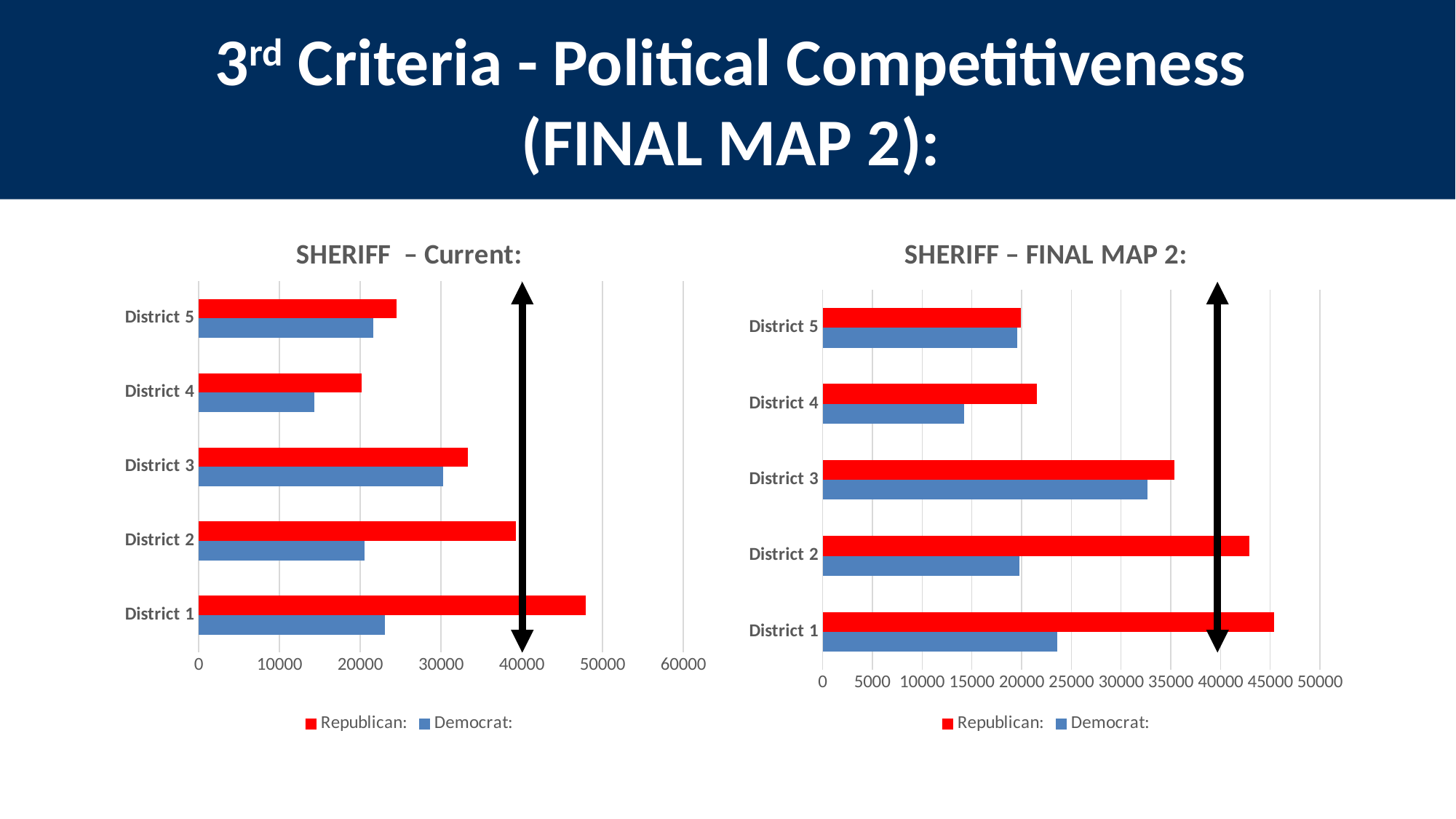
In the "SHERIFF – Current:" chart, which is larger for District 2, the Republican value or the Democrat value? Republican In the "SHERIFF – Current:" chart, is the Democrat value for District 4 greater or less than 20000? less What kind of chart is the "SHERIFF – Current:" chart? bar chart In the "SHERIFF – FINAL MAP 2:" chart, is the Republican value for District 3 greater or less than 30000? greater In the "SHERIFF – FINAL MAP 2:" chart, which district has the highest Republican value? District 1 In the "SHERIFF – Current:" chart, which district has the lowest Democrat value? District 4 In the "SHERIFF – Current:" chart, which district has the highest Republican value? District 1 How many series does the legend of the "SHERIFF – FINAL MAP 2:" chart list? 2 What colour are the Democrat bars in the "SHERIFF – FINAL MAP 2:" chart? blue In the "SHERIFF – FINAL MAP 2:" chart, which district has the lowest Democrat value? District 4 How many districts are shown on the "SHERIFF – Current:" chart? 5 In the "SHERIFF – Current:" chart, is the Republican value for District 1 greater or less than 40000? greater